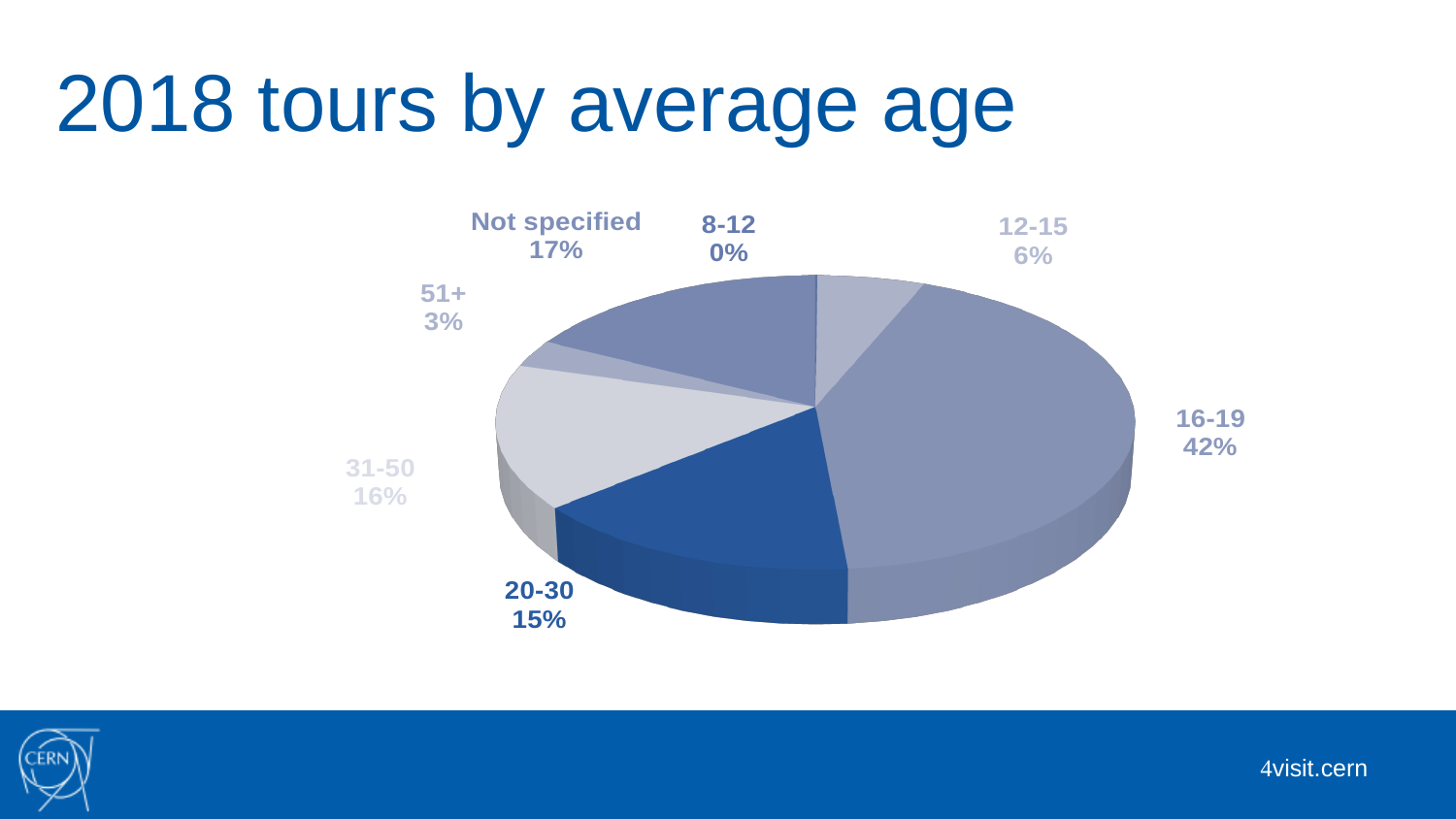
What kind of chart is shown on the slide? Pie chart What is the title of the chart? 2018 tours by average age Which age group has the smallest share of tours? 8-12 Which age group has the largest share of tours? 16-19 How many categories are shown in the pie chart? 7 What is the combined share of the 31-50 and 51+ age groups? 19% What share of tours is for the 20-30 age group? 15% What share of tours is for the 16-19 age group? 42% What share of tours is for the 51+ age group? 3% Which has a larger share, the 12-15 group or the 20-30 group? 20-30 What is the difference in share between the 16-19 and 31-50 age groups? 26% What share of tours is labelled Not specified? 17%